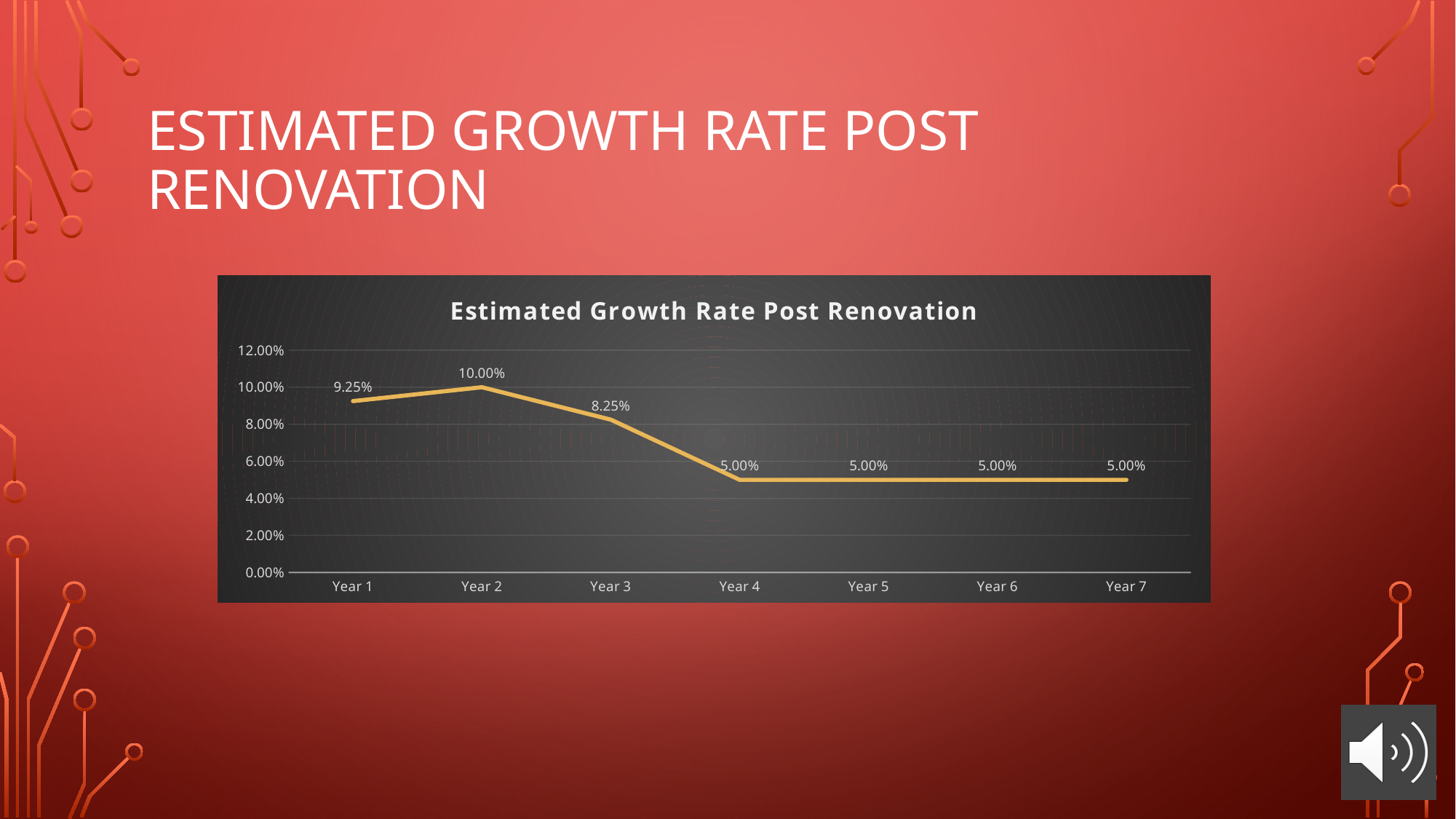
What is the estimated growth rate for Year 1? 9.25% What is the estimated growth rate for Year 6? 5.00% What is the difference between the growth rate in Year 2 and Year 3? 1.75% What is the difference between the growth rate in Year 1 and Year 4? 4.25% Which is larger, the growth rate in Year 1 or Year 3? Year 1 How many years are plotted on the x axis? 7 Which year has the highest estimated growth rate? Year 2 Is the value for Year 2 greater or less than 8.00%? greater What kind of chart is shown on the slide? Line chart Does the growth rate rise or fall from Year 2 to Year 4? Fall What is the title of the chart? Estimated Growth Rate Post Renovation What is the estimated growth rate for Year 3? 8.25%